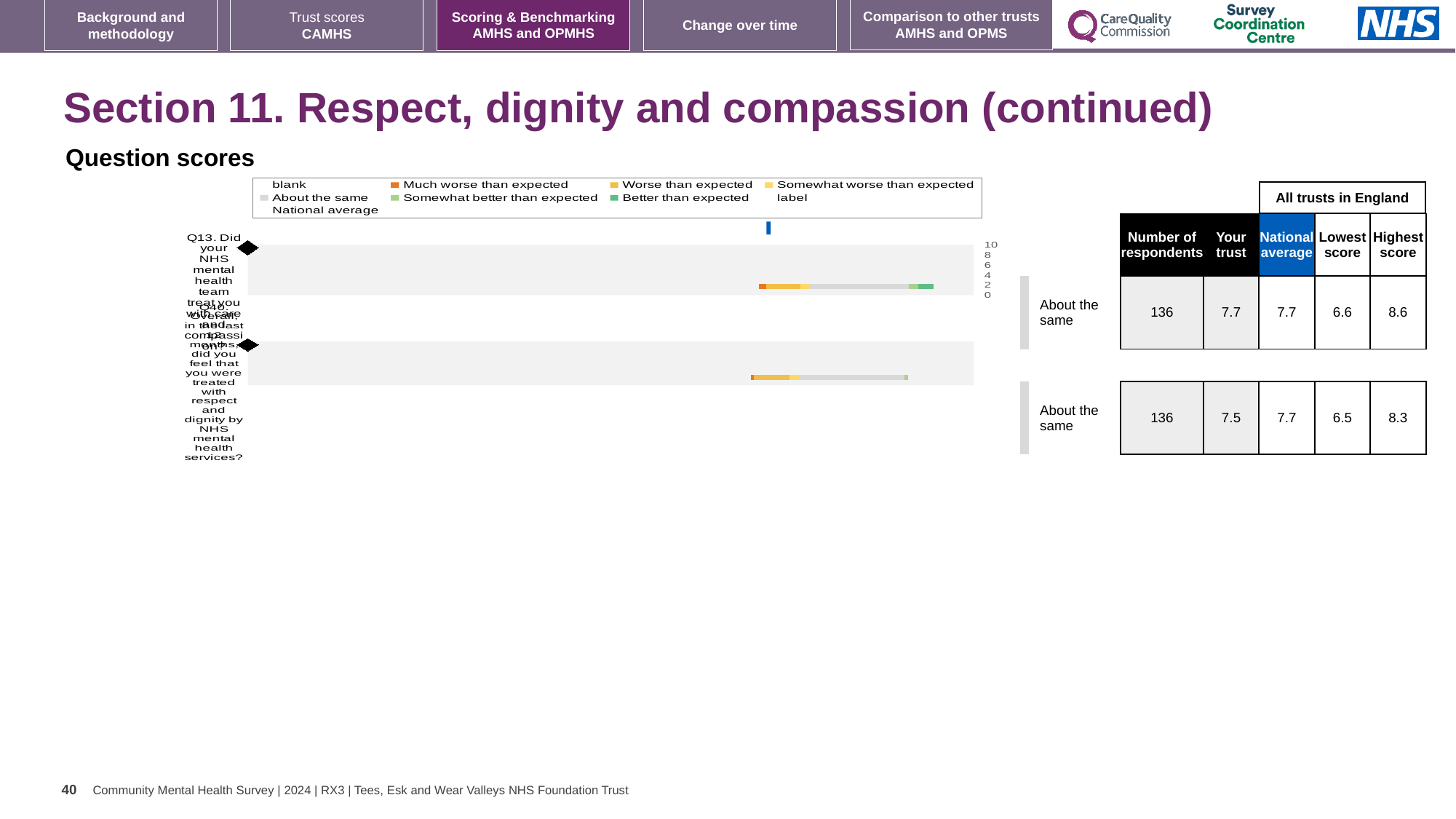
What is the national average score for Q10? 7.7 What is the 'Your trust' score for Q10 (respect and dignity)? 7.5 How many respondents answered Q10? 136 What is the difference between the highest and lowest scores for Q10? 1.8 What is the lowest score across all trusts in England for Q13? 6.6 How much higher is the highest score than the 'Your trust' score for Q13? 0.9 How many questions are plotted in the question scores chart? 2 What is the 'Your trust' score for Q13 (care and compassion)? 7.7 What is the highest score across all trusts in England for Q13? 8.6 What benchmark category is shown for Q13 next to the chart? About the same What kind of chart is used to show the question scores on this slide? bar chart Which question has the higher 'Your trust' score, Q13 or Q10? Q13